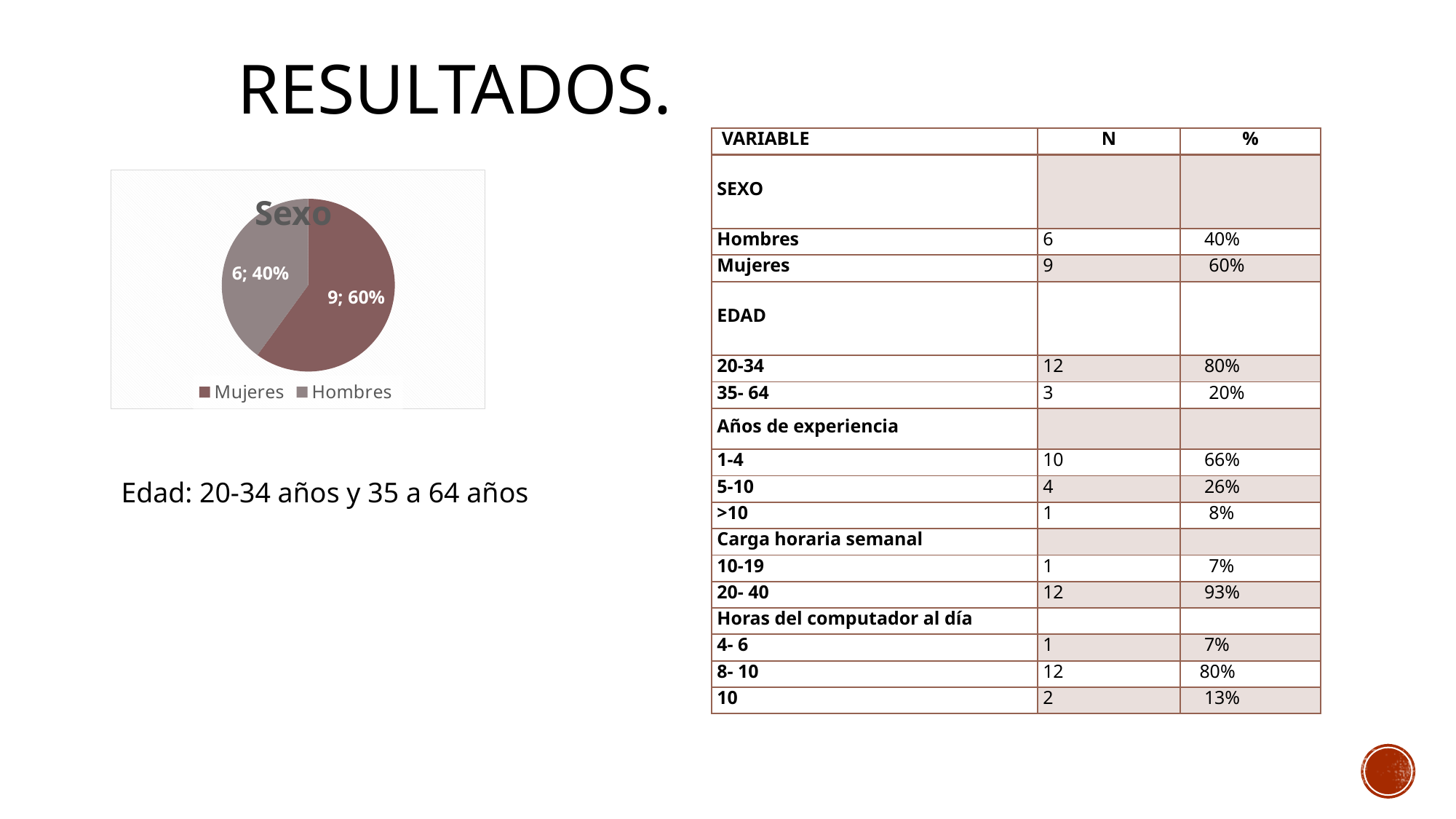
How many entries does the legend of the pie chart list? 2 Which legend entry of the pie chart is listed first? Mujeres Which slice of the pie chart is the smallest? Hombres Which slice of the pie chart is the largest? Mujeres What is the count shown for Hombres in the pie chart? 6 What share of the pie does Hombres represent? 40% What share of the pie does Mujeres represent? 60% What is the count shown for Mujeres in the pie chart? 9 What is the title of the pie chart? Sexo What is the difference between the counts for Mujeres and Hombres in the pie chart? 3 What kind of chart is shown on the slide? pie chart How many slices does the pie chart have? 2